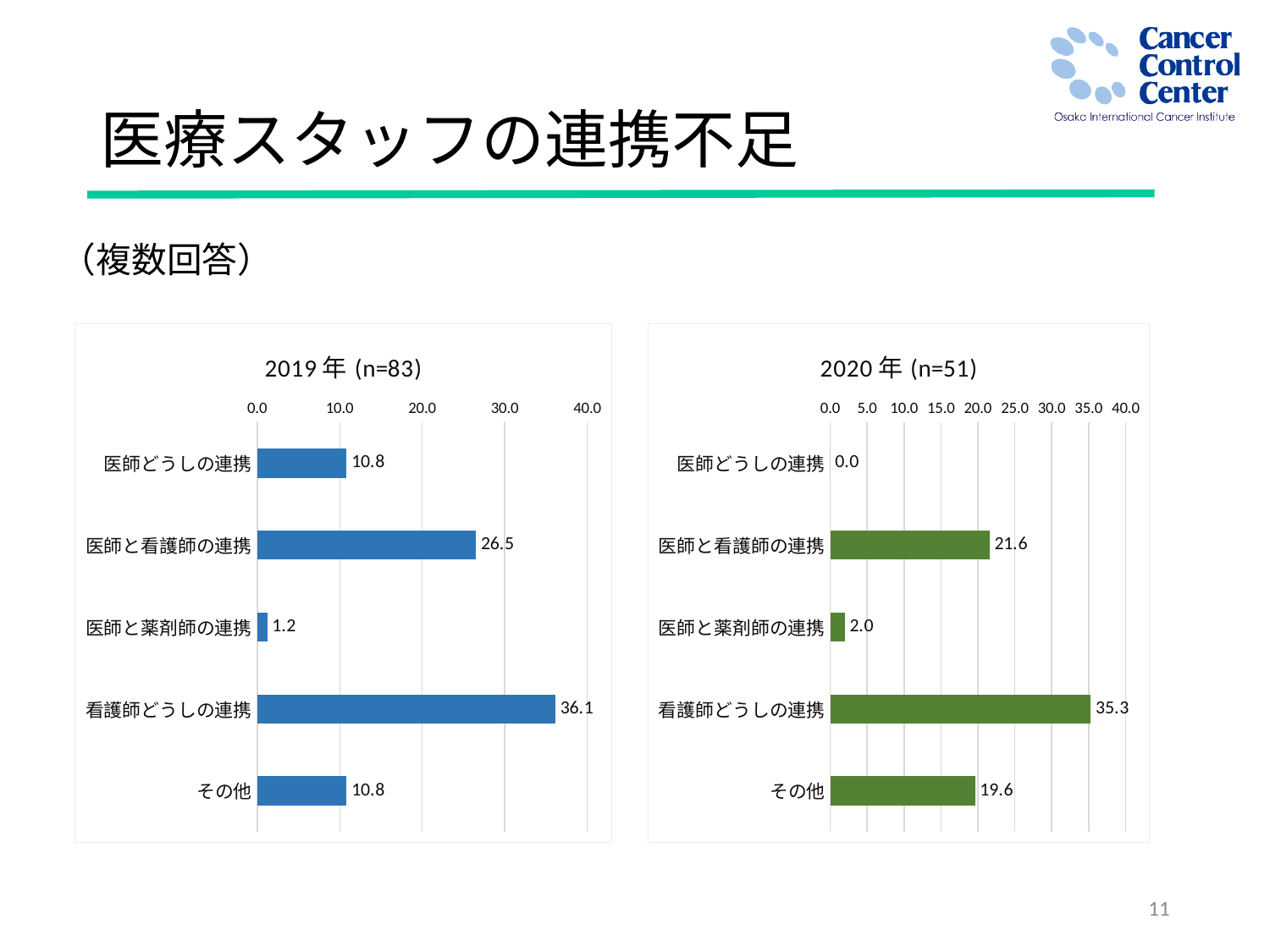
In the 2019年 (n=83) chart, what is the difference between 医師と看護師の連携 and 医師どうしの連携? 15.7 What kind of chart is the 2019年 (n=83) chart? Bar chart In the 2020年 (n=51) chart, what is the value for 医師と看護師の連携? 21.6 In the 2020年 (n=51) chart, what is the value for 医師どうしの連携? 0.0 Which is larger: 医師と看護師の連携 in the 2019年 (n=83) chart or 医師と看護師の連携 in the 2020年 (n=51) chart? 2019年 (n=83) In the 2019年 (n=83) chart, what is the value for 看護師どうしの連携? 36.1 How many categories are shown in the 2020年 (n=51) chart? 5 In the 2020年 (n=51) chart, what is the difference between 看護師どうしの連携 and その他? 15.7 In the 2020年 (n=51) chart, which category has the lowest value? 医師どうしの連携 What colour are the bars in the 2020年 (n=51) chart? Green In the 2019年 (n=83) chart, which category has the lowest value? 医師と薬剤師の連携 In the 2019年 (n=83) chart, which category has the highest value? 看護師どうしの連携